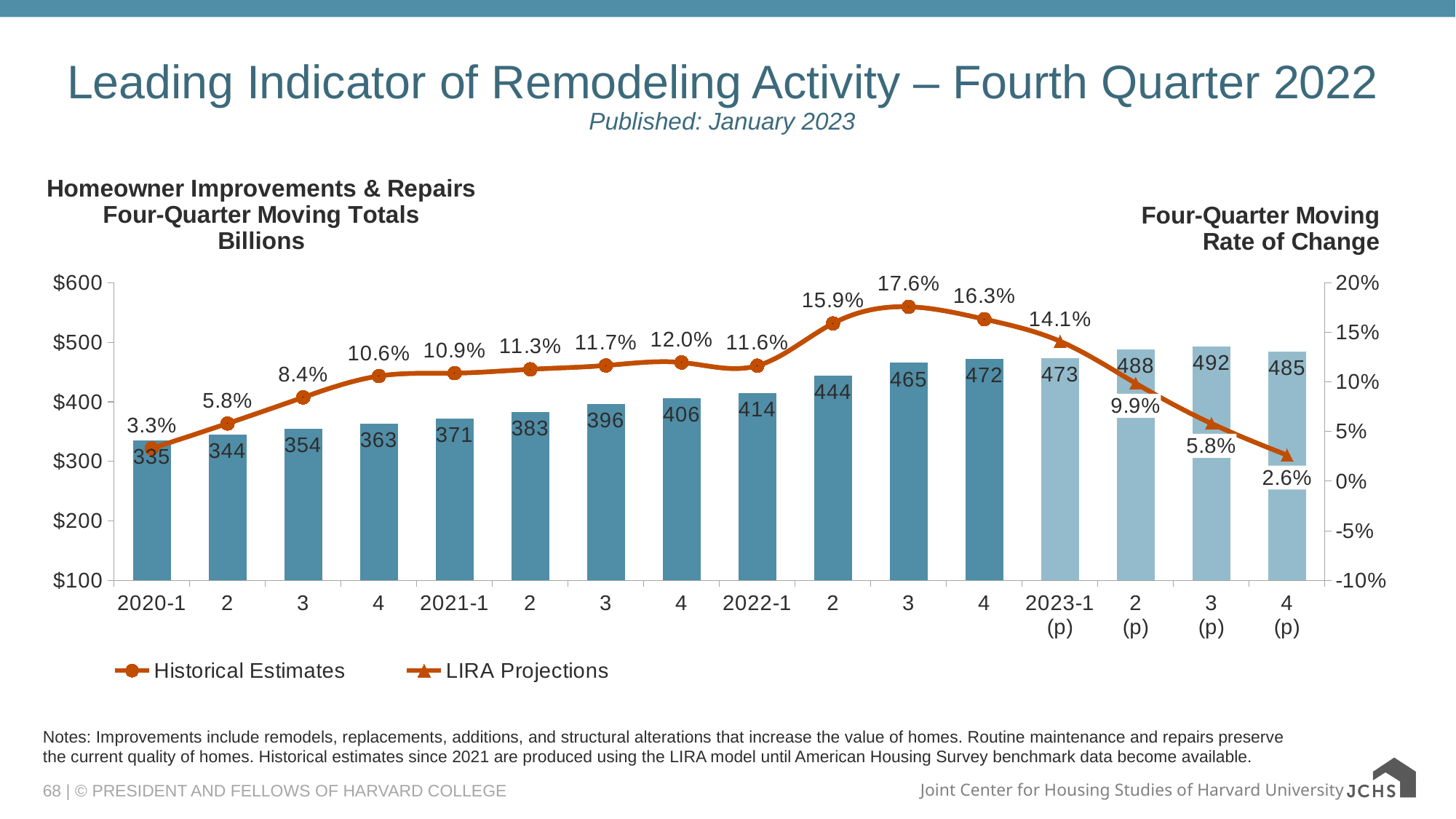
What is the four-quarter moving rate of change for 2022-3? 17.6% What is the projected four-quarter moving rate of change for 2023-4 (p)? 2.6% Which quarter has the highest four-quarter moving rate of change? 2022-3 Which is larger, the four-quarter moving total for 2023-2 (p) or for 2023-4 (p)? 2023-2 (p) Which quarter has the lowest four-quarter moving total? 2020-1 Does the four-quarter moving rate of change rise or fall from 2023-1 (p) to 2023-4 (p)? fall What is the difference between the four-quarter moving totals for 2022-2 and 2022-1? 30 What is the projected four-quarter moving total for 2023-3 (p)? 492 How many quarters are shown on the x axis? 16 What are the two series named in the legend? Historical Estimates and LIRA Projections What is the four-quarter moving total (in billions) for 2022-4? 472 How many series does the legend list? 2